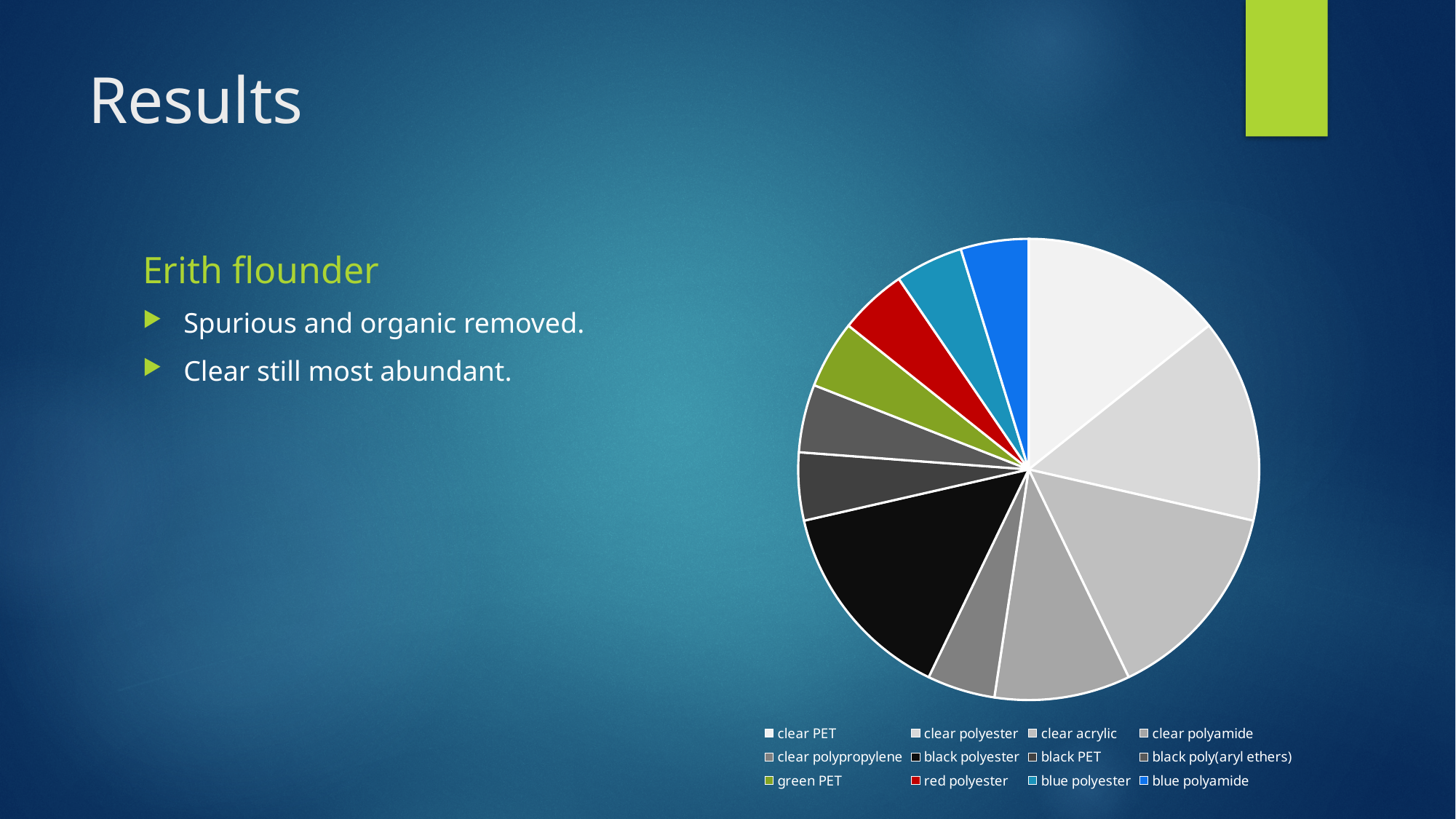
What colour is the red polyester slice in the pie chart? red How many entries does the pie chart's legend list? 12 Which slice is larger, clear acrylic or blue polyester? clear acrylic Which slice is larger, black polyester or blue polyamide? black polyester Which slice is larger, clear polyester or red polyester? clear polyester How many slices does the pie chart have? 12 What kind of chart is shown on the slide? pie chart Which legend entry is shown in green? green PET